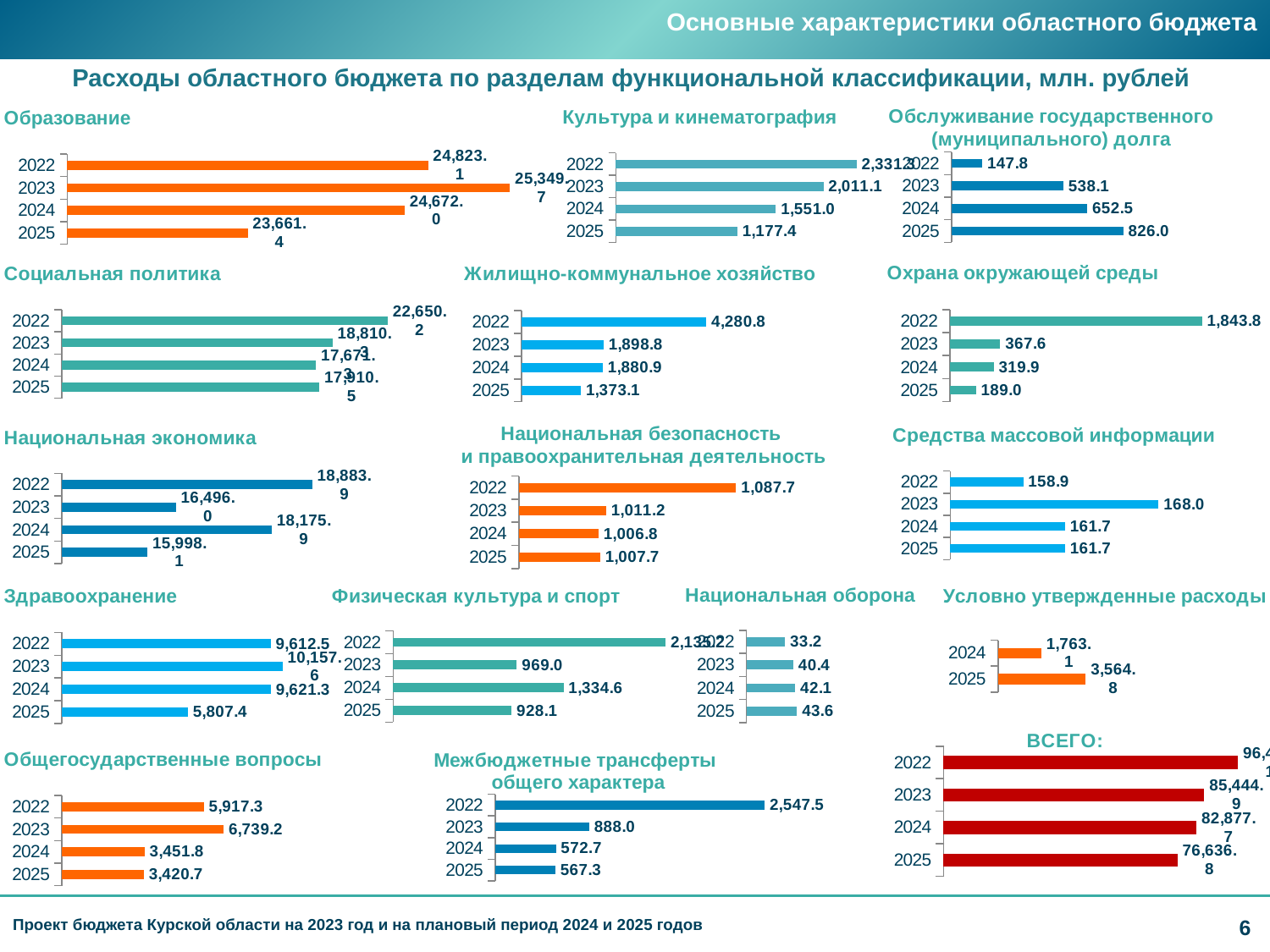
In the 'Жилищно-коммунальное хозяйство' chart, what is the value for 2022? 4,280.8 What type of chart is used for 'Общегосударственные вопросы'? bar chart In the 'Национальная оборона' chart, do the values rise or fall from 2022 to 2025? rise In the 'Обслуживание государственного (муниципального) долга' chart, what is the value for 2025? 826.0 How many years are shown in the 'Условно утвержденные расходы' chart? 2 In the 'Здравоохранение' chart, which is larger: the value for 2023 or the value for 2025? 2023 In the 'Межбюджетные трансферты общего характера' chart, what is the difference between the 2022 and 2023 values? 1,659.5 In the 'Культура и кинематография' chart, what is the value for 2024? 1,551.0 In the 'ВСЕГО:' chart, what is the value for 2025? 76,636.8 In the 'Средства массовой информации' chart, what is the value for 2023? 168.0 In the 'Национальная экономика' chart, which year has the highest value? 2022 In the 'Охрана окружающей среды' chart, which year has the lowest value? 2025